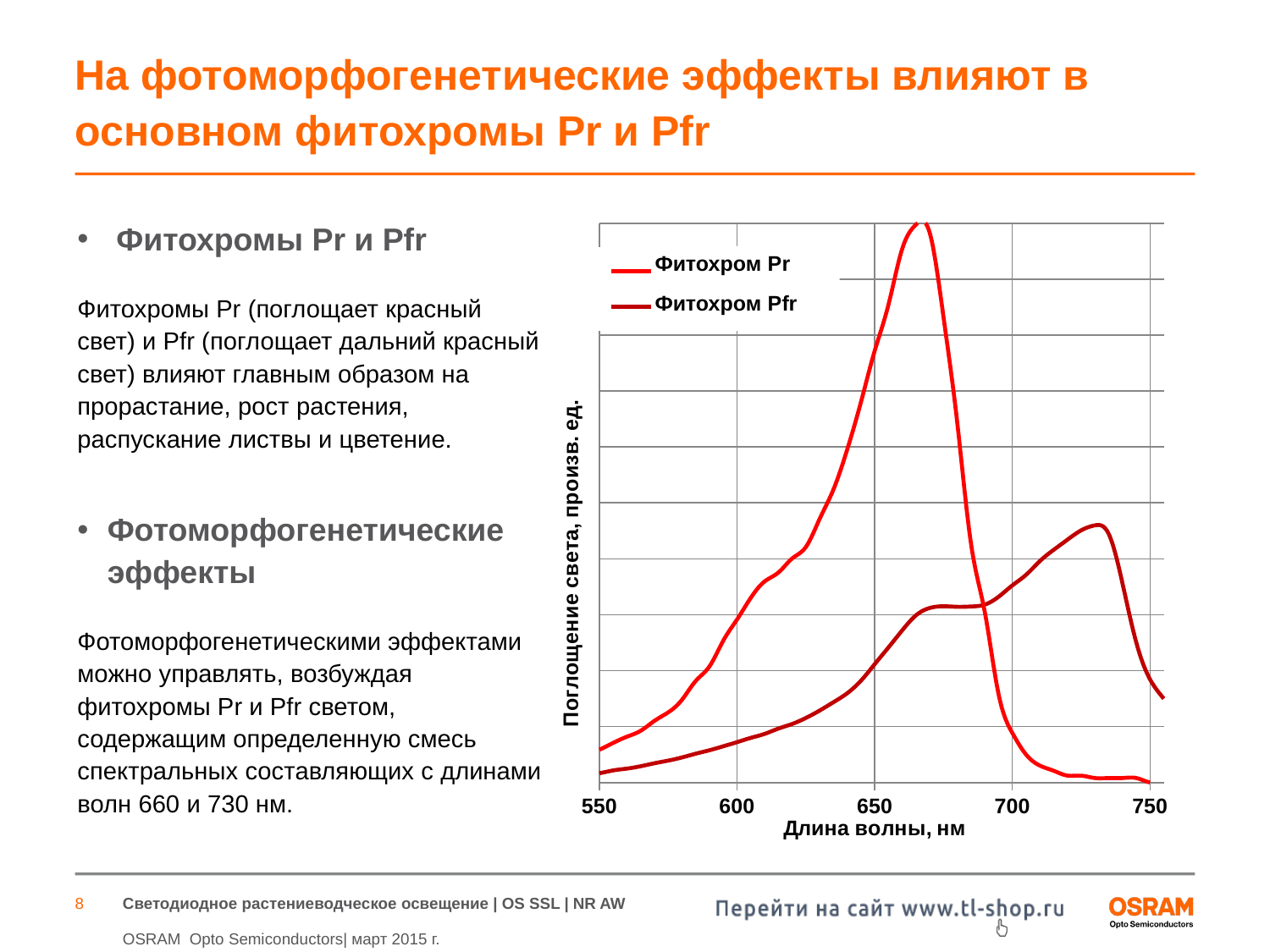
Does the Фитохром Pr curve rise or fall between 700 nm and 750 nm? fall How many series does the chart legend list? 2 What is the lowest wavelength value labelled on the x axis? 550 What kind of chart is shown on the slide? line chart What is the title of the chart's x axis? Длина волны, нм At a wavelength of 600 nm, which series has the higher absorption, Фитохром Pr or Фитохром Pfr? Фитохром Pr At a wavelength of 700 nm, which series has the higher absorption, Фитохром Pr or Фитохром Pfr? Фитохром Pfr Is the peak of the Фитохром Pr curve at a wavelength greater or less than 650 nm? greater Does the Фитохром Pr curve rise or fall between 550 nm and 650 nm? rise What are the two series named in the chart legend? Фитохром Pr and Фитохром Pfr Which series reaches the higher peak value, Фитохром Pr or Фитохром Pfr? Фитохром Pr Is the peak of the Фитохром Pfr curve at a wavelength greater or less than 700 nm? greater